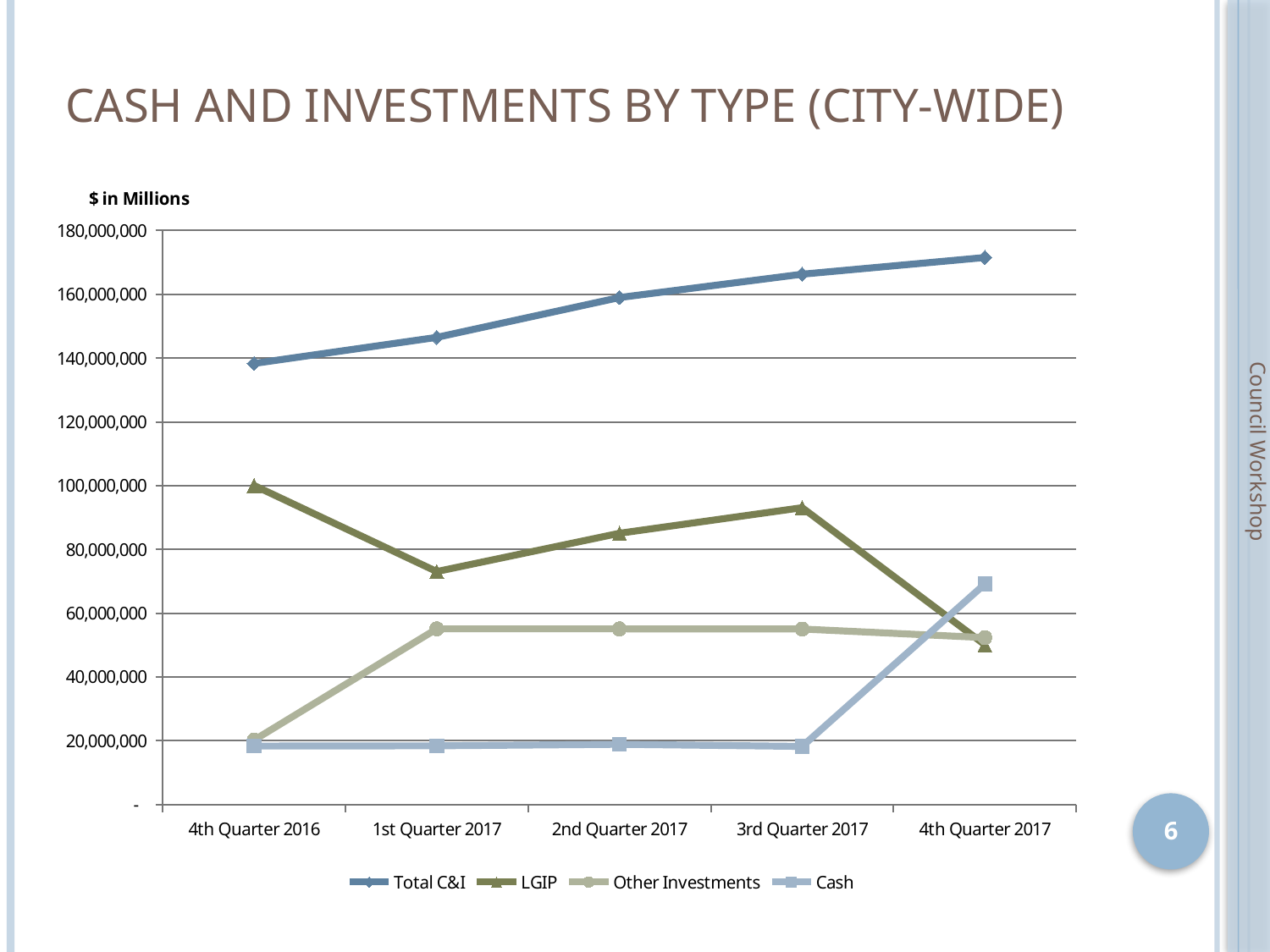
Is the value for Cash in 4th Quarter 2017 greater or less than 60,000,000? greater In which quarter is Total C&I highest? 4th Quarter 2017 In which quarter is LGIP highest? 4th Quarter 2016 What kind of chart is shown on the slide? line chart In 4th Quarter 2017, which is larger: Cash or Other Investments? Cash Is the value for Total C&I in 4th Quarter 2016 greater or less than 120,000,000? greater In which quarter is LGIP lowest? 4th Quarter 2017 Does the Total C&I line rise or fall from 4th Quarter 2016 to 4th Quarter 2017? rise Is the value for Other Investments in 1st Quarter 2017 greater or less than 40,000,000? greater How many quarters are plotted along the x axis? 5 How many series does the legend list? 4 In 3rd Quarter 2017, which is larger: LGIP or Other Investments? LGIP